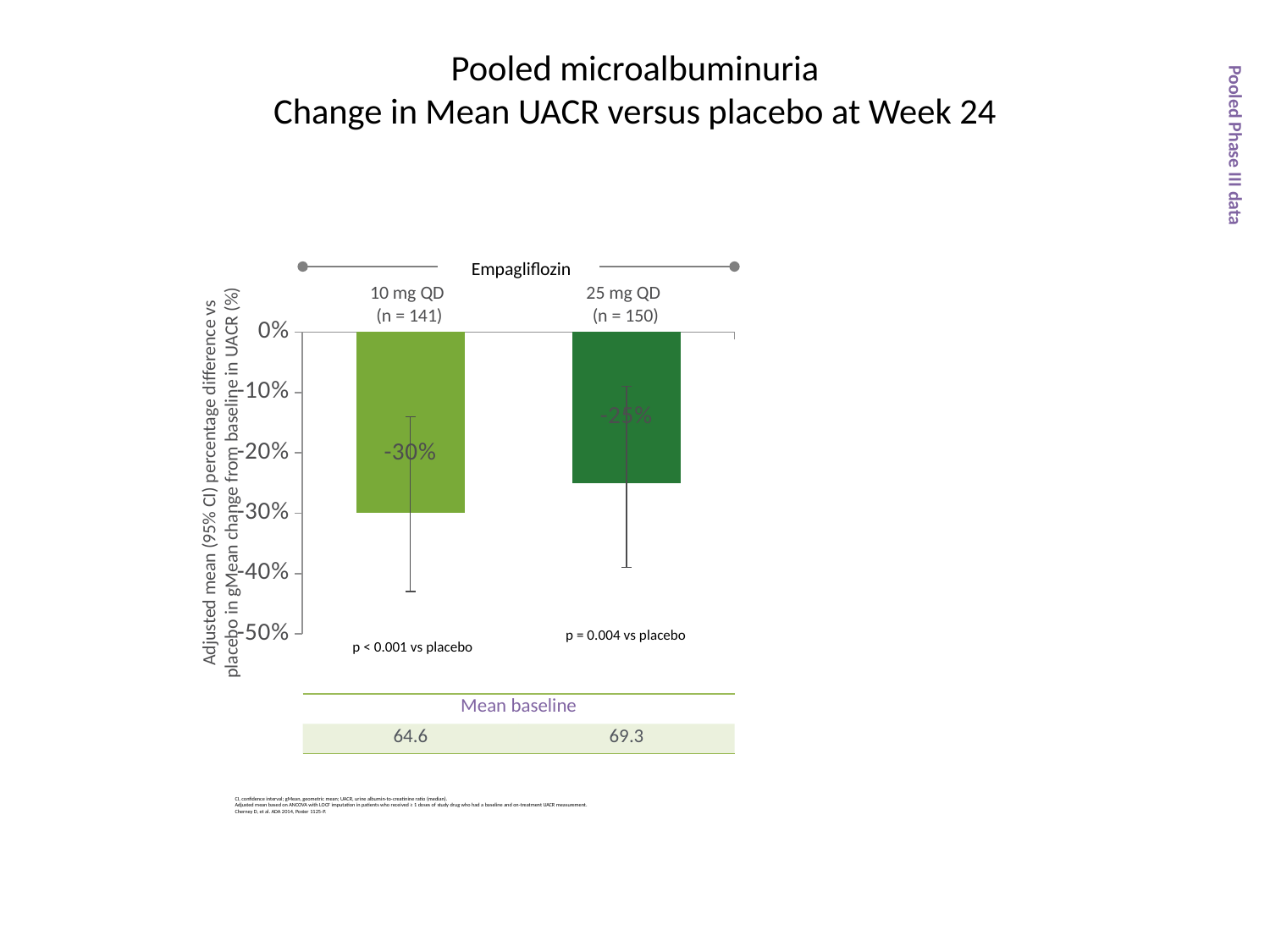
What is the difference between the UACR changes for the 10 mg QD and 25 mg QD doses? 5 percentage points Which dose shows the highest (least negative) change in UACR versus placebo? 25 mg QD How many dose groups are plotted in the chart? 2 What is the adjusted mean percentage difference in UACR versus placebo for empagliflozin 25 mg QD? -25% Is the value for 25 mg QD greater or less than -20%? less How many patients (n) are in the 10 mg QD group? 141 Which dose shows the lowest (most negative) change in UACR versus placebo? 10 mg QD What is the mean baseline UACR for the 25 mg QD group? 69.3 What is the mean baseline UACR for the 10 mg QD group? 64.6 Which dose has a larger reduction in UACR versus placebo, 10 mg QD or 25 mg QD? 10 mg QD What is the adjusted mean percentage difference in UACR versus placebo for empagliflozin 10 mg QD? -30% What kind of chart is shown on the slide? bar chart